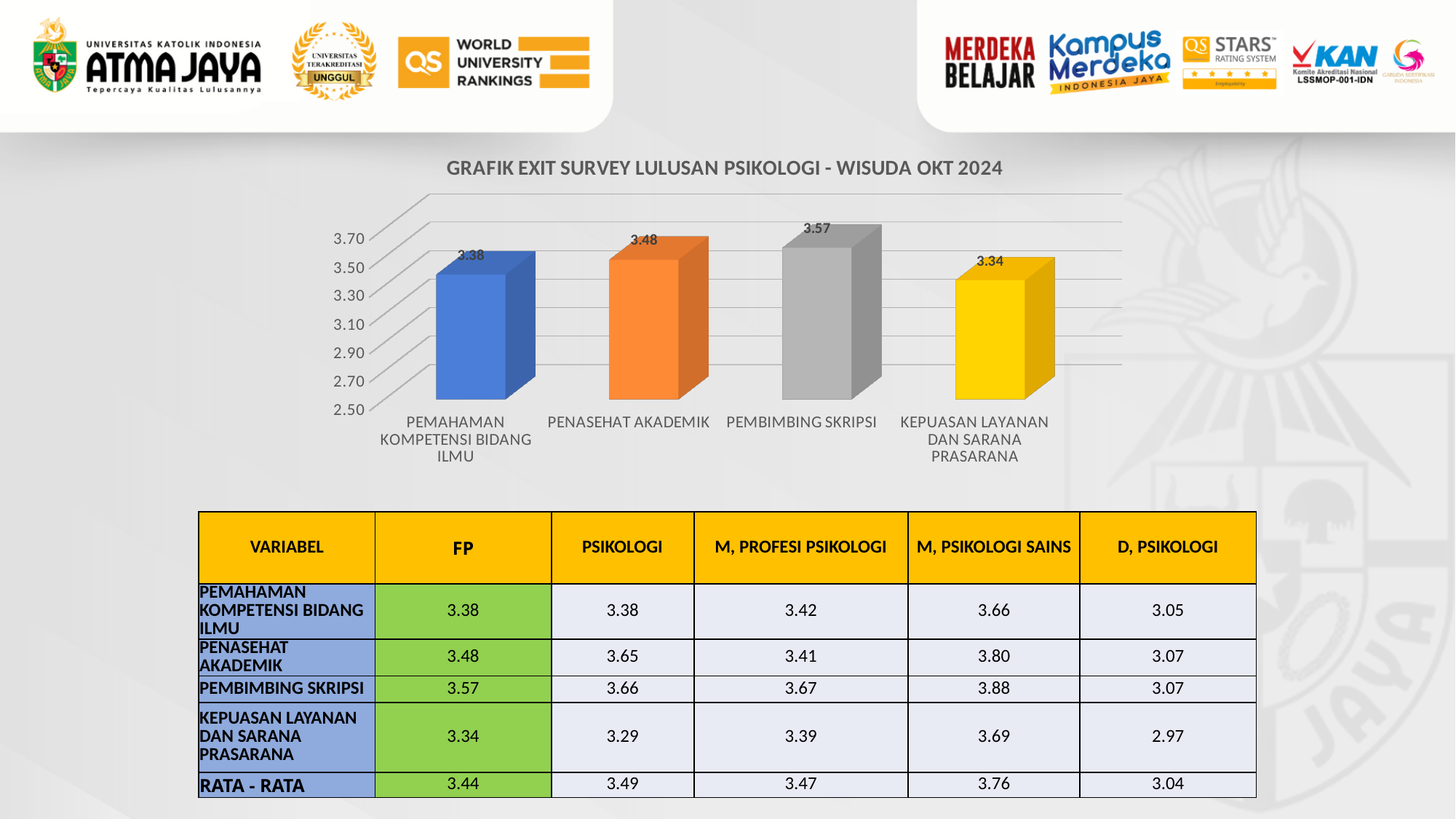
Which category has the highest value in the chart? PEMBIMBING SKRIPSI What is the value for KEPUASAN LAYANAN DAN SARANA PRASARANA in the chart? 3.34 Which is larger, the value for PENASEHAT AKADEMIK or the value for PEMAHAMAN KOMPETENSI BIDANG ILMU? PENASEHAT AKADEMIK What is the title of the chart? GRAFIK EXIT SURVEY LULUSAN PSIKOLOGI - WISUDA OKT 2024 How many categories are shown in the chart? 4 What is the difference between the values for PENASEHAT AKADEMIK and PEMAHAMAN KOMPETENSI BIDANG ILMU? 0.10 Which category has the lowest value in the chart? KEPUASAN LAYANAN DAN SARANA PRASARANA What is the value for PENASEHAT AKADEMIK in the chart? 3.48 Is the value for PEMBIMBING SKRIPSI greater or less than 3.50? greater What is the difference between the values for PEMBIMBING SKRIPSI and KEPUASAN LAYANAN DAN SARANA PRASARANA? 0.23 What is the value for PEMBIMBING SKRIPSI in the chart? 3.57 What kind of chart is shown on the slide? bar chart